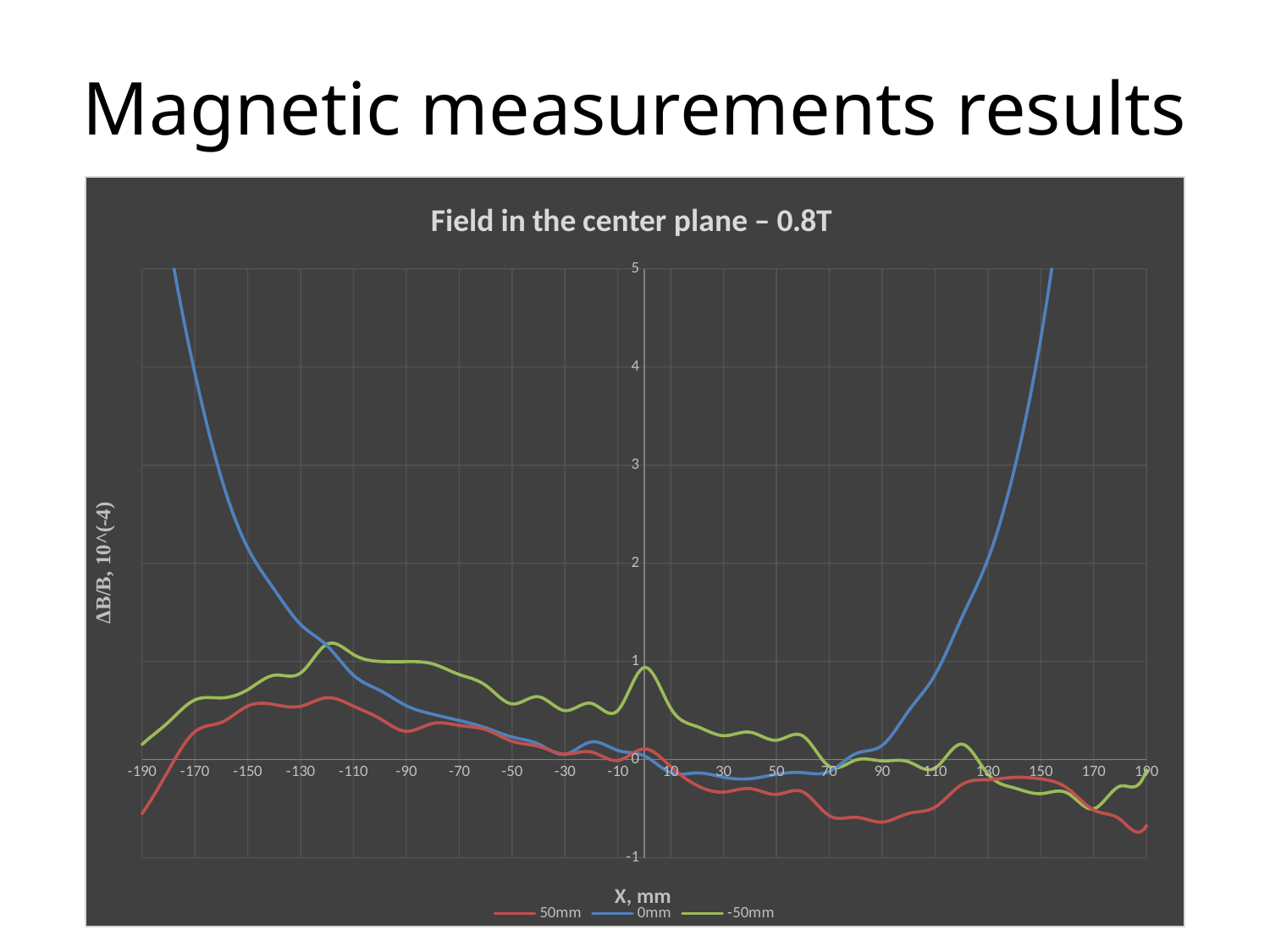
Is the value of the 0mm series at X = -150 greater or less than 2? greater Is the value of the -50mm series at X = -120 greater or less than 1? greater Is the value of the 50mm series at X = 190 greater or less than 0? less At X = -170, which series has the larger value, 0mm or 50mm? 0mm At X = 0, which series has the larger value, -50mm or 50mm? -50mm What is the title of the chart? Field in the center plane – 0.8T What kind of chart is shown on the slide? line chart What is the label of the x axis? X, mm Does the 0mm series rise or fall as X increases from 90 to 150? rise How many series does the legend list? 3